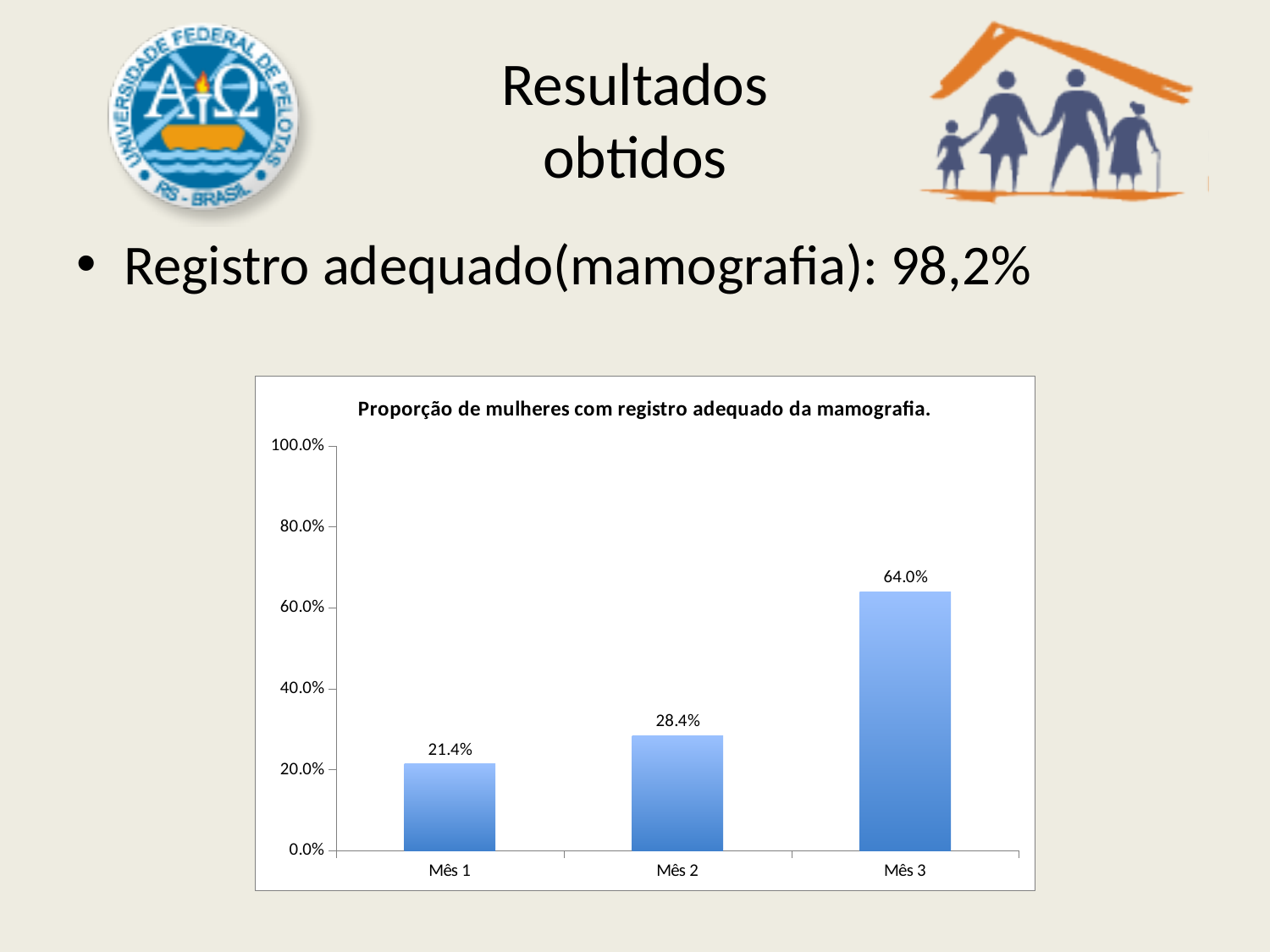
What is the value for Mês 1? 21.4% Which month has the lowest proportion? Mês 1 What is the difference between the values for Mês 3 and Mês 2? 35.6% Is the value for Mês 3 greater or less than 60.0%? greater Which is larger, the value for Mês 1 or the value for Mês 2? Mês 2 What kind of chart is shown on the slide? bar chart Do the values rise or fall from Mês 1 to Mês 3? rise What is the value for Mês 2? 28.4% What is the value for Mês 3? 64.0% What is the difference between the values for Mês 2 and Mês 1? 7.0% Which month has the highest proportion? Mês 3 How many categories are shown on the x axis? 3